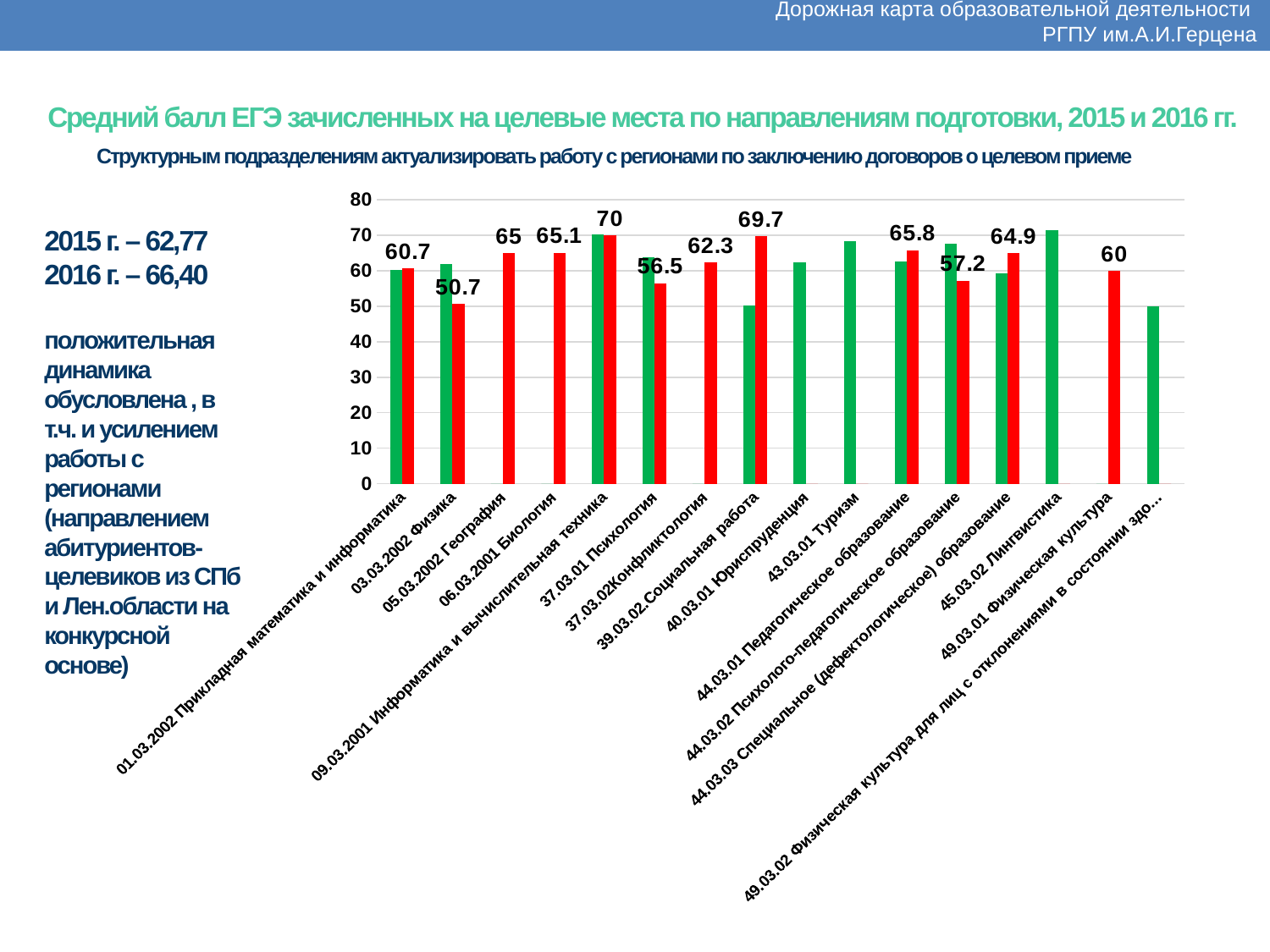
Is the green bar for 39.03.02 Социальная работа greater or less than 60? less Is the green bar for 45.03.02 Лингвистика greater or less than 70? greater What is the difference between the red-bar values for 44.03.01 Педагогическое образование and 44.03.02 Психолого-педагогическое образование? 8.6 Which category has the highest labelled red-bar value? 09.03.2001 Информатика и вычислительная техника What is the value shown on the red bar for 03.03.2002 Физика? 50.7 What is the value shown on the red bar for 37.03.01 Психология? 56.5 What is the value shown on the red bar for 39.03.02 Социальная работа? 69.7 What is the value shown on the red bar for 44.03.02 Психолого-педагогическое образование? 57.2 What is the difference between the red-bar values for 39.03.02 Социальная работа and 03.03.2002 Физика? 19 Which has the larger red-bar value: 03.03.2002 Физика or 37.03.01 Психология? 37.03.01 Психология What type of chart is shown on the slide? bar chart Which category has the lowest labelled red-bar value? 03.03.2002 Физика